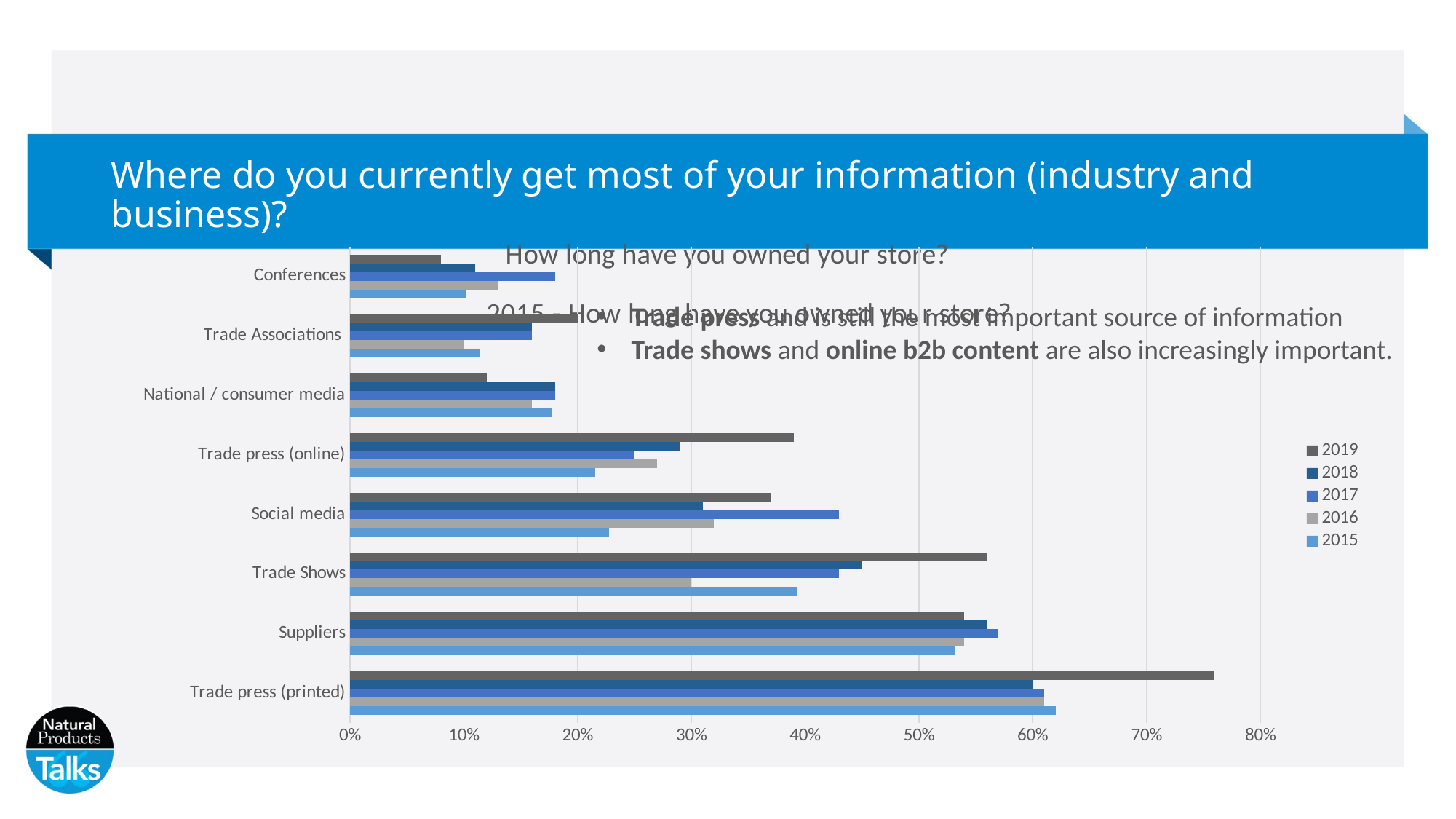
Which category has the longest bar for 2019? Trade press (printed) What kind of chart is shown on the slide? Bar chart Which category has the shortest bar for 2019? Conferences Is the 2019 value for Conferences greater or less than 10%? less Is the 2019 value for Trade press (printed) greater or less than 70%? greater Which is larger for 2019: Trade press (printed) or Suppliers? Trade press (printed) Which years are listed in the chart legend? 2019, 2018, 2017, 2016, 2015 How many categories are listed on the vertical axis of the chart? 8 How many series does the chart legend list? 5 For Social media, which year has the larger value: 2017 or 2015? 2017 Is the 2017 value for Social media greater or less than 40%? greater